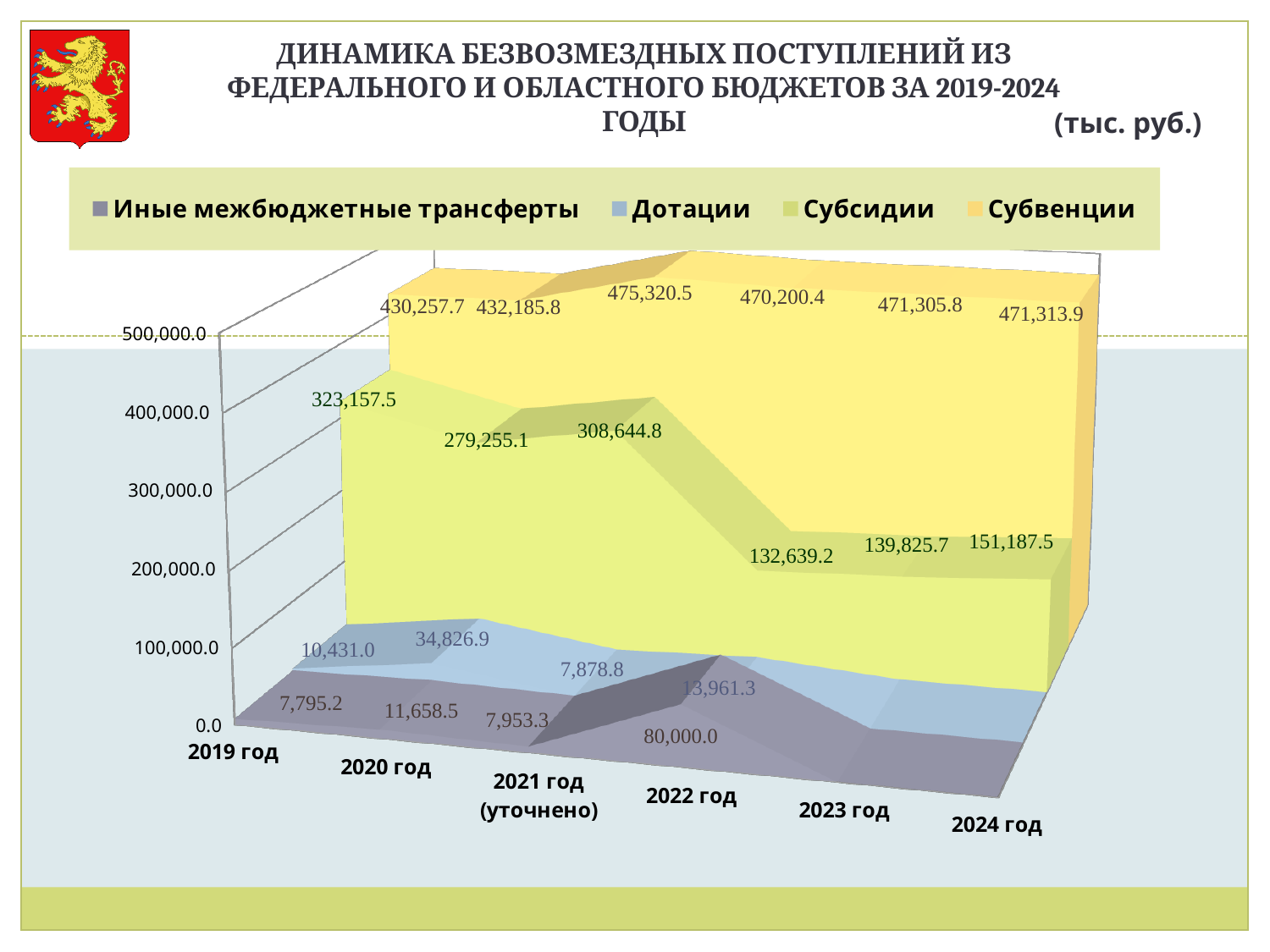
What is the value for Субвенции in 2024 год? 471,313.9 What is the difference between the Субсидии values for 2019 год and 2024 год? 171,970.0 What is the value for Субвенции in 2021 год (уточнено)? 475,320.5 What is the value for Субсидии in 2019 год? 323,157.5 What kind of chart is shown on the slide? Area chart What is the value for Субсидии in 2024 год? 151,187.5 In which year is the value for Субсидии the lowest? 2022 год In which year is the value for Субвенции the highest? 2021 год (уточнено) How many years are shown on the x axis? 6 How many series does the legend list? 4 Which is larger: the Субсидии value for 2020 год or for 2021 год (уточнено)? 2021 год (уточнено) Does the value for Субсидии rise or fall from 2019 год to 2022 год? Fall